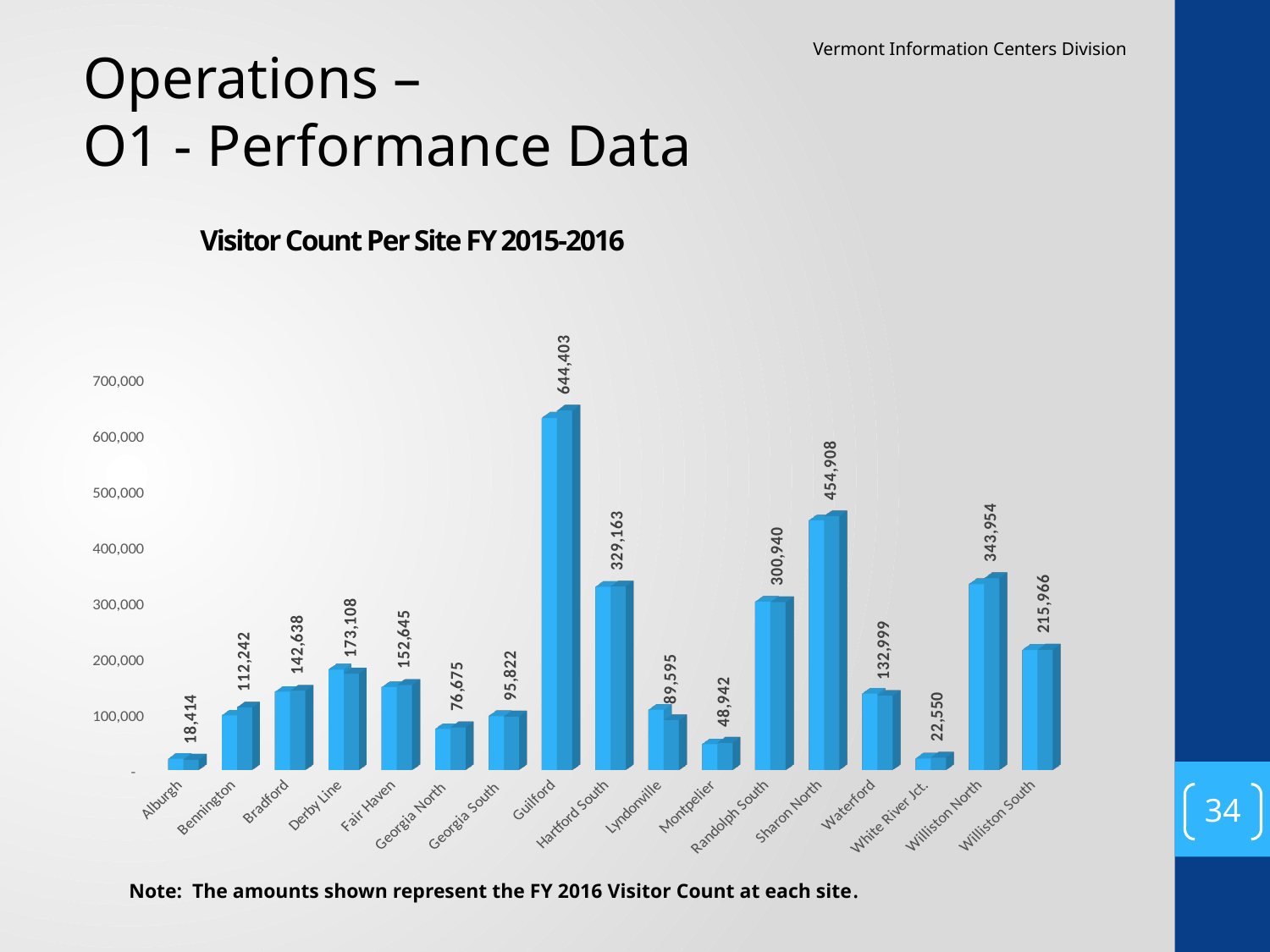
What is the visitor count for Guilford? 644,403 What is the difference in visitor count between Guilford and Sharon North? 189,495 What type of chart is used to show the visitor counts? Bar chart Which site has a larger visitor count, Hartford South or Randolph South? Hartford South What is the visitor count for White River Jct.? 22,550 What is the visitor count for Randolph South? 300,940 Which site has the highest visitor count? Guilford What is the difference in visitor count between Williston North and Williston South? 127,988 How many sites are shown in the chart? 17 Which site has the lowest visitor count? Alburgh Is the visitor count for Waterford greater or less than 200,000? less Which site has a larger visitor count, Derby Line or Fair Haven? Derby Line